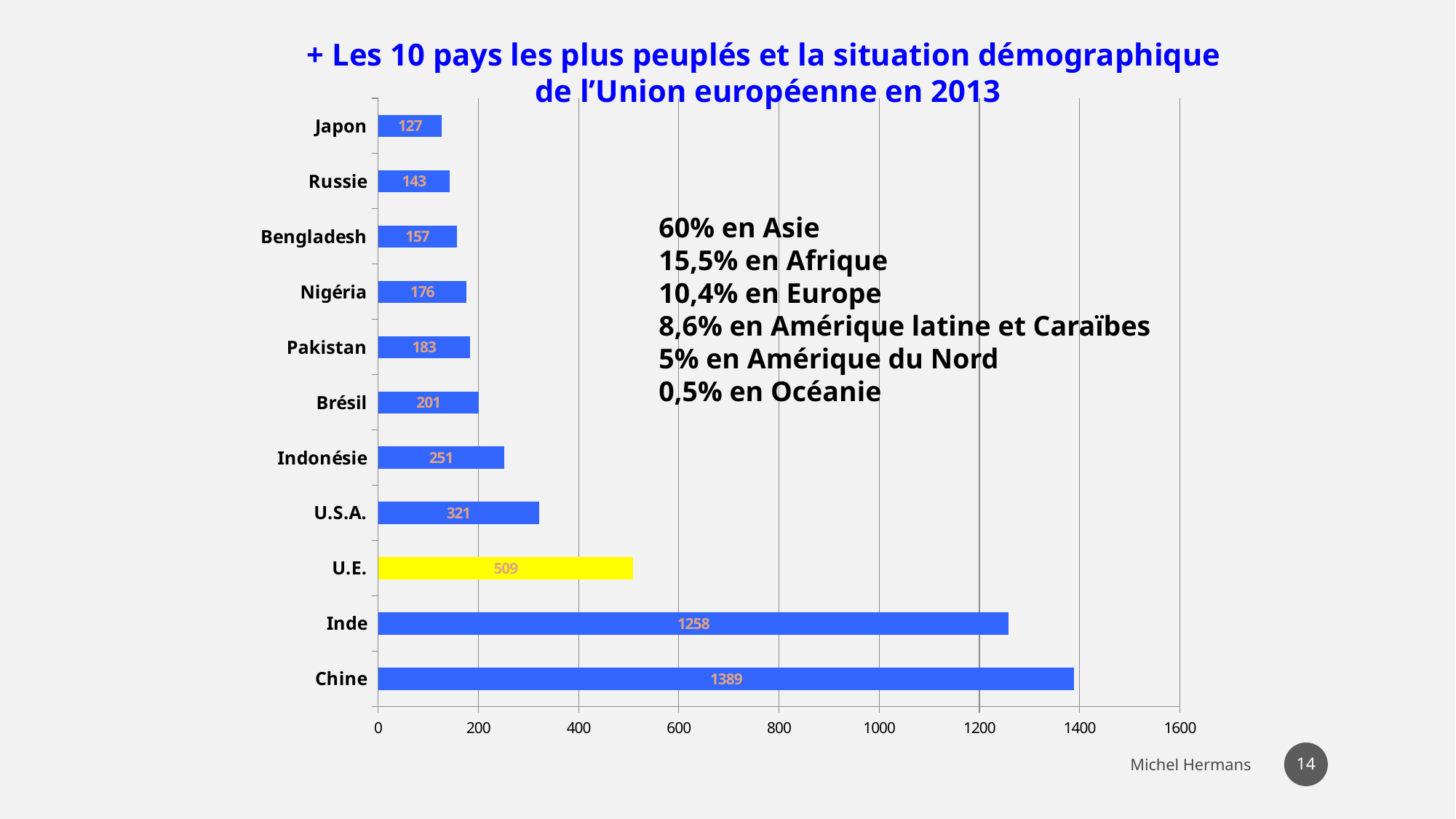
What is the difference between the values for Chine and Inde? 131 What kind of chart is shown on the slide? bar chart Is the value for Inde greater or less than 1200? greater What is the value for U.E.? 509 How many categories are shown in the chart? 11 Which category has the highest value? Chine What is the difference between the values for U.E. and U.S.A.? 188 What is the value for Chine? 1389 Which bar is coloured yellow instead of blue? U.E. What is the value for Indonésie? 251 Which category has the lowest value? Japon Which is larger, the value for Pakistan or the value for Nigéria? Pakistan